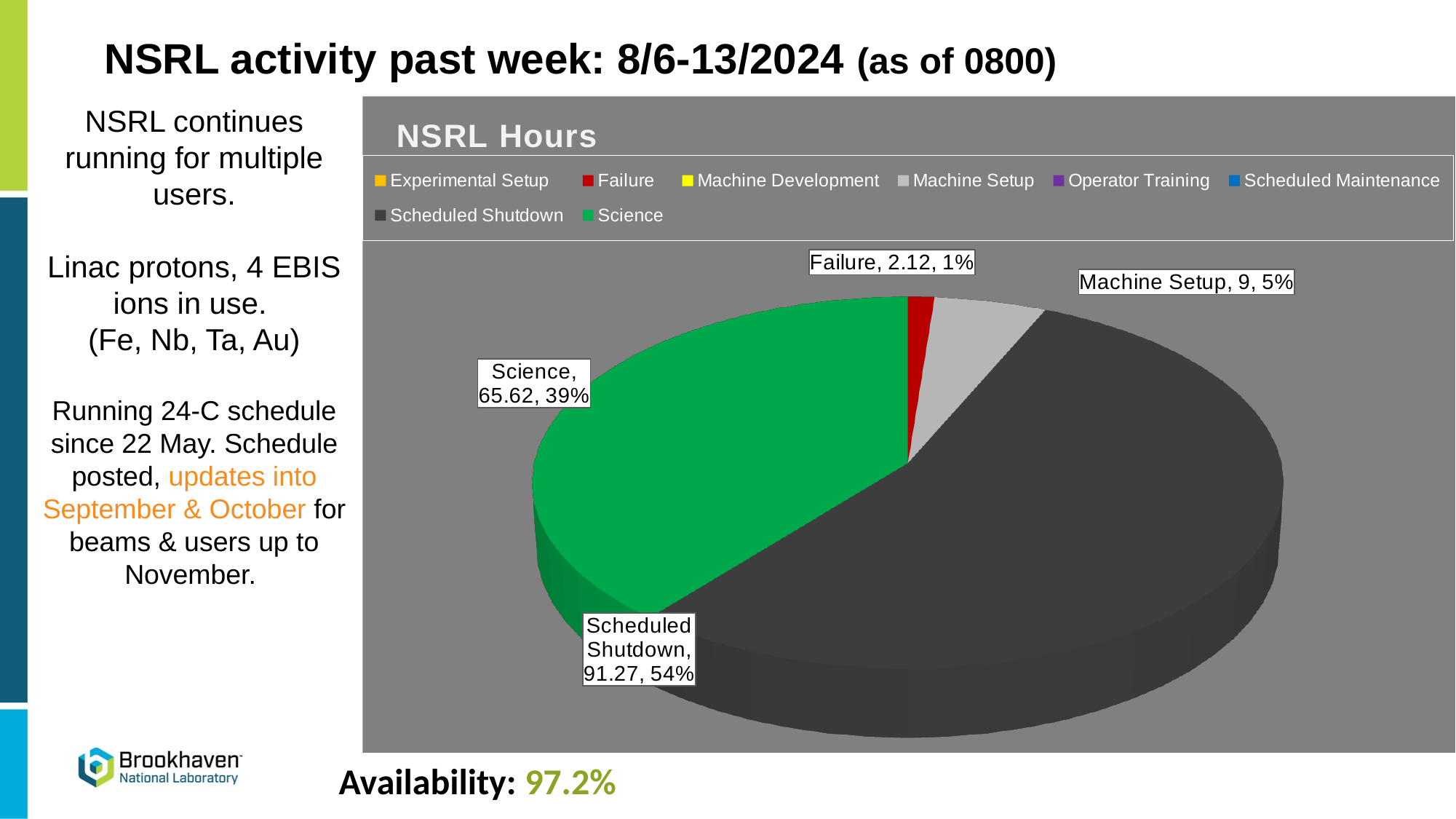
Which category has the largest slice of the pie? Scheduled Shutdown What share of the pie does Science represent? 39% What is the difference in hours between Scheduled Shutdown and Science? 25.65 How many hours are shown for Machine Setup? 9 How many entries does the chart legend list? 8 What type of chart is shown on the slide? pie chart What is the title of the chart? NSRL Hours How many hours are shown for Failure? 2.12 How many hours are shown for Science? 65.62 Which is larger, the hours for Machine Setup or the hours for Failure? Machine Setup How many hours are shown for Scheduled Shutdown? 91.27 Which labelled category has the smallest slice of the pie? Failure